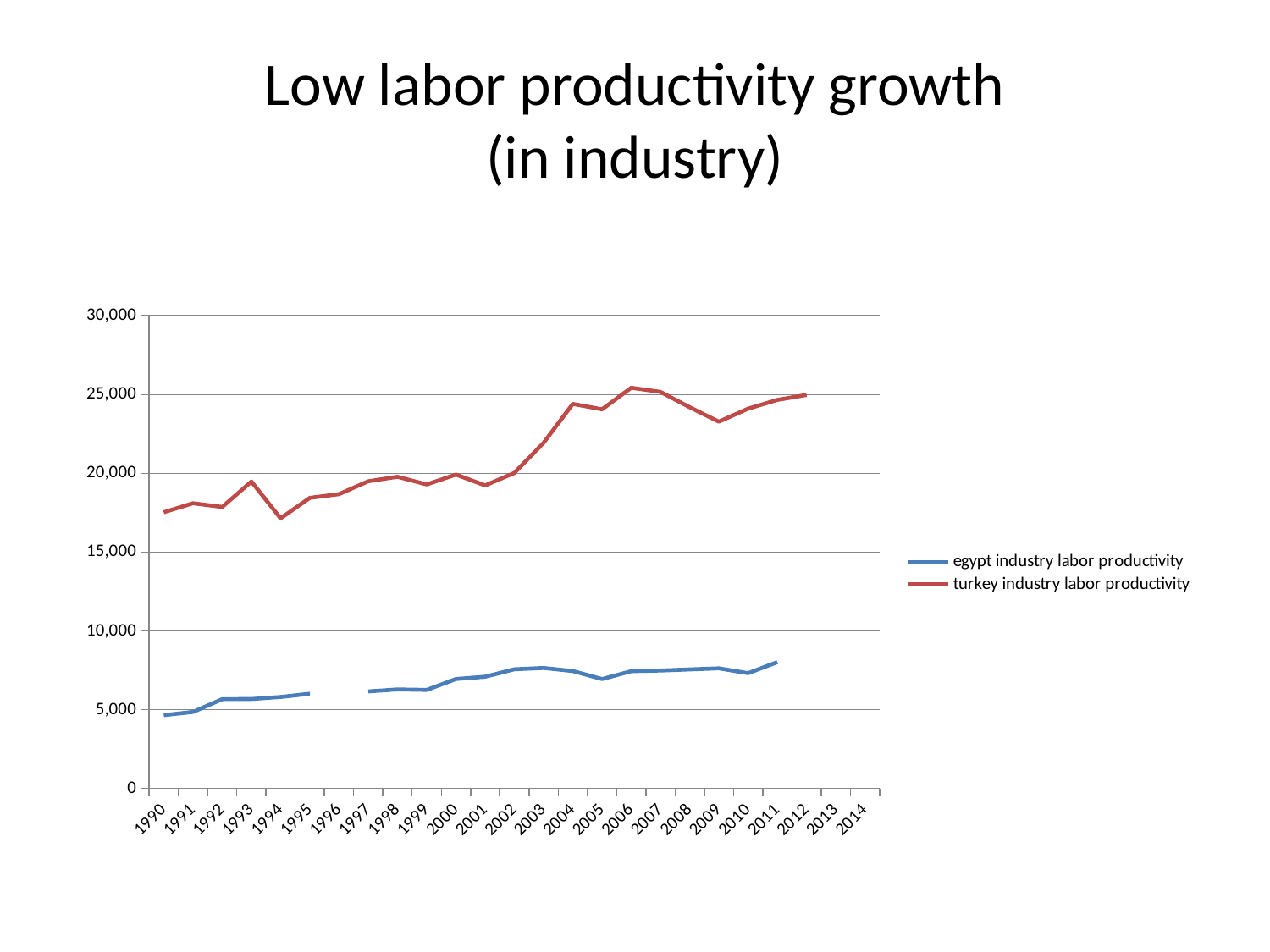
How many year labels are shown on the x axis? 25 Is the value for egypt industry labor productivity in 2003 greater or less than 5,000? greater Which colour is used for the egypt industry labor productivity line? blue Is the value for turkey industry labor productivity in 1994 greater or less than 20,000? less In 2000, which series has the larger value, egypt industry labor productivity or turkey industry labor productivity? turkey industry labor productivity Is the value for turkey industry labor productivity in 1990 greater or less than 15,000? greater How many series does the legend list? 2 Does turkey industry labor productivity rise or fall overall from 1990 to 2012? rise What kind of chart is shown on the slide? line chart What is the title of the slide? Low labor productivity growth (in industry)